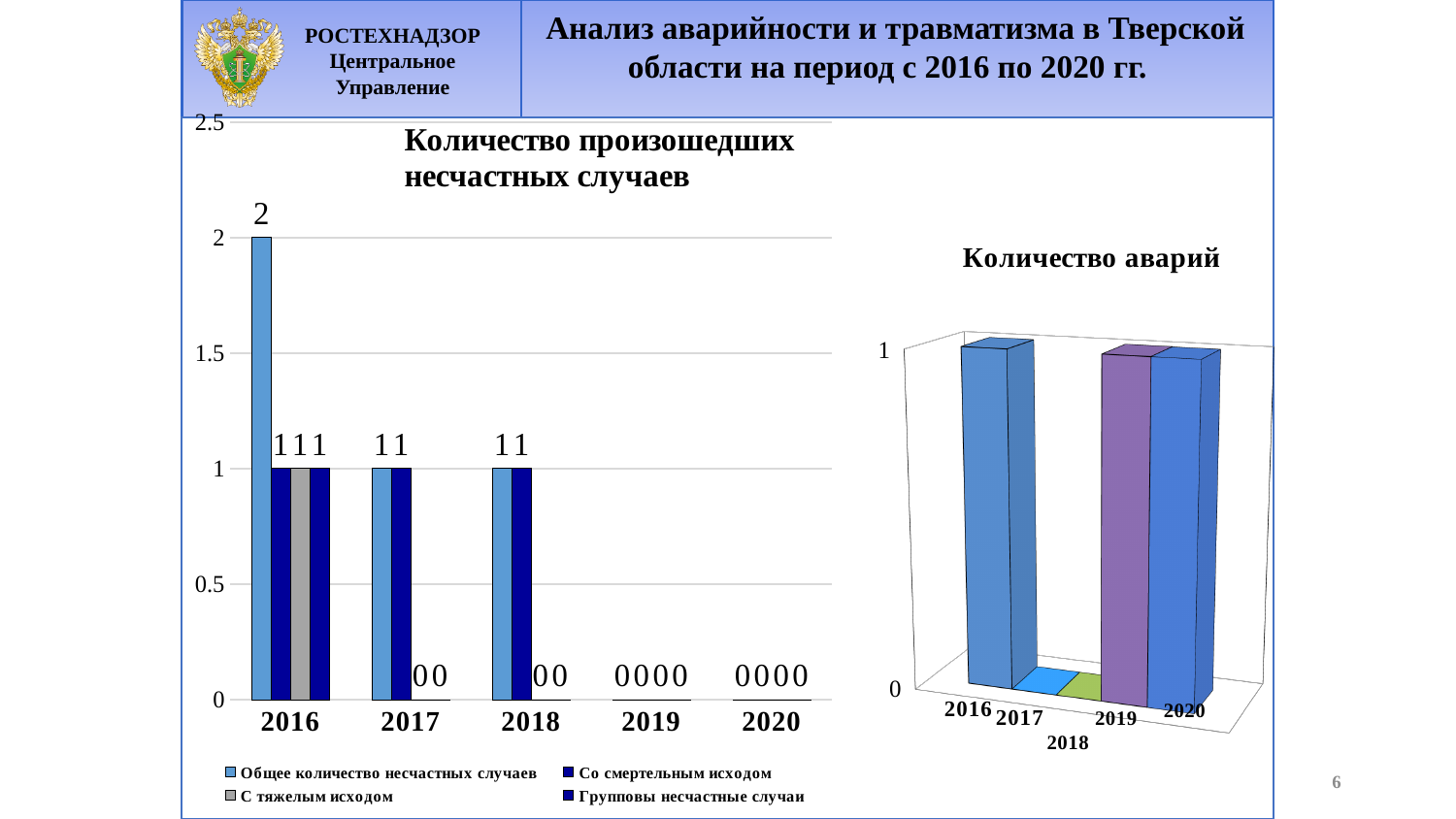
In the right chart "Количество аварий", what is the value for 2017? 0 In the left chart "Количество произошедших несчастных случаев", what is the difference between "Общее количество несчастных случаев" in 2016 and in 2017? 1 How many years are shown in the right chart "Количество аварий"? 5 How many years are shown on the x axis of the left chart "Количество произошедших несчастных случаев"? 5 In the left chart "Количество произошедших несчастных случаев", what is the value of "Со смертельным исходом" for 2018? 1 In the left chart "Количество произошедших несчастных случаев", what is the value of "Общее количество несчастных случаев" for 2016? 2 In the right chart "Количество аварий", which is larger, the value for 2018 or the value for 2019? 2019 In the right chart "Количество аварий", what is the value for 2016? 1 How many series does the legend of the left chart "Количество произошедших несчастных случаев" list? 4 What kind of chart is the left chart titled "Количество произошедших несчастных случаев"? bar chart In the left chart "Количество произошедших несчастных случаев", does "Общее количество несчастных случаев" rise or fall from 2016 to 2020? fall In the left chart "Количество произошедших несчастных случаев", which year has the highest value of "Общее количество несчастных случаев"? 2016